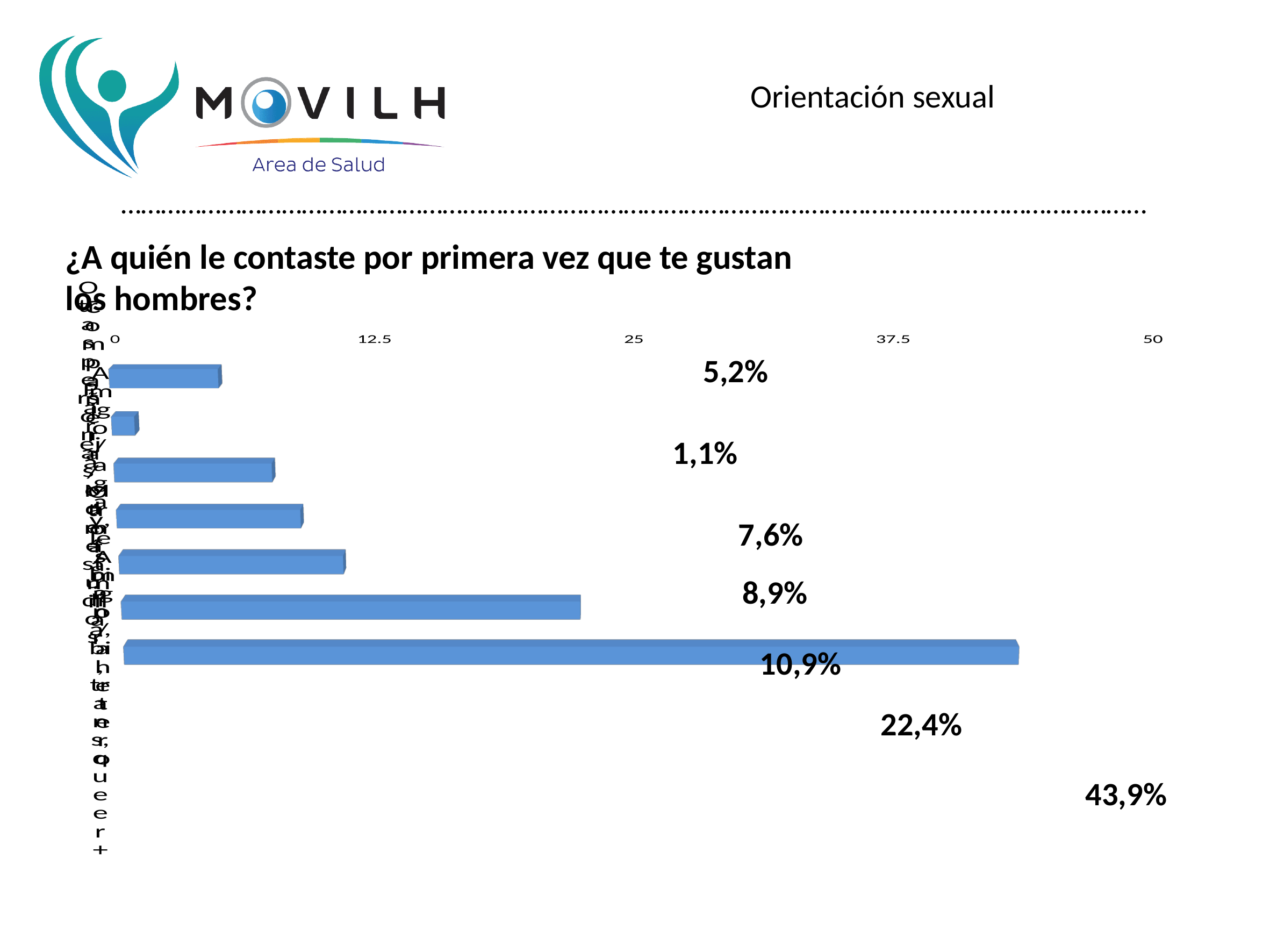
How many bars does the chart contain? 7 What is the value of the second-longest bar in the chart? 22,4% What is the highest value shown on the horizontal axis? 50 What is the difference between the longest bar (43,9%) and the shortest bar (1,1%)? 42,8% What kind of chart is shown on the slide? bar chart What is the value of the topmost bar in the chart? 5,2% What is the value of the shortest bar in the chart? 1,1% What question does the chart title ask? ¿A quién le contaste por primera vez que te gustan los hombres? Which is larger: the topmost bar or the second bar from the top? the topmost bar Is the value of the second-longest bar greater or less than 25? less What is the value of the longest bar in the chart? 43,9% Is the value of the longest bar greater or less than 37.5? greater